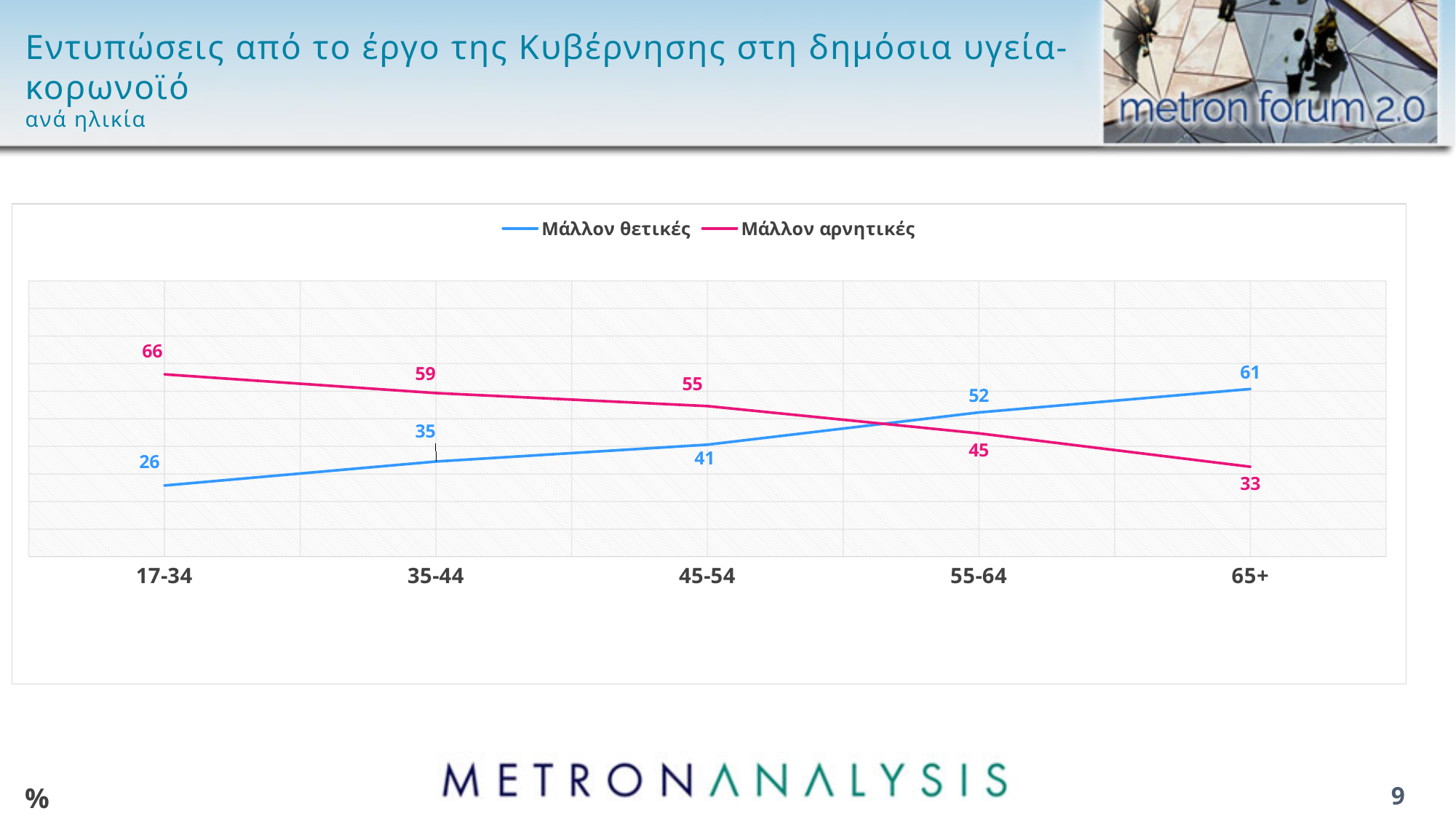
Which age group has the lowest value for Μάλλον αρνητικές? 65+ What is the difference between Μάλλον αρνητικές and Μάλλον θετικές for the 17-34 age group? 40 How many series does the legend list? 2 What colour is the line for Μάλλον θετικές? Blue For the 55-64 age group, which is larger: Μάλλον θετικές or Μάλλον αρνητικές? Μάλλον θετικές What is the value of Μάλλον θετικές for the 17-34 age group? 26 What kind of chart is shown on the slide? Line chart Does the Μάλλον αρνητικές series rise or fall from 17-34 to 65+? Fall How many age groups are shown on the x axis? 5 Which age group has the highest value for Μάλλον θετικές? 65+ What is the value of Μάλλον αρνητικές for the 45-54 age group? 55 What is the value of Μάλλον αρνητικές for the 65+ age group? 33